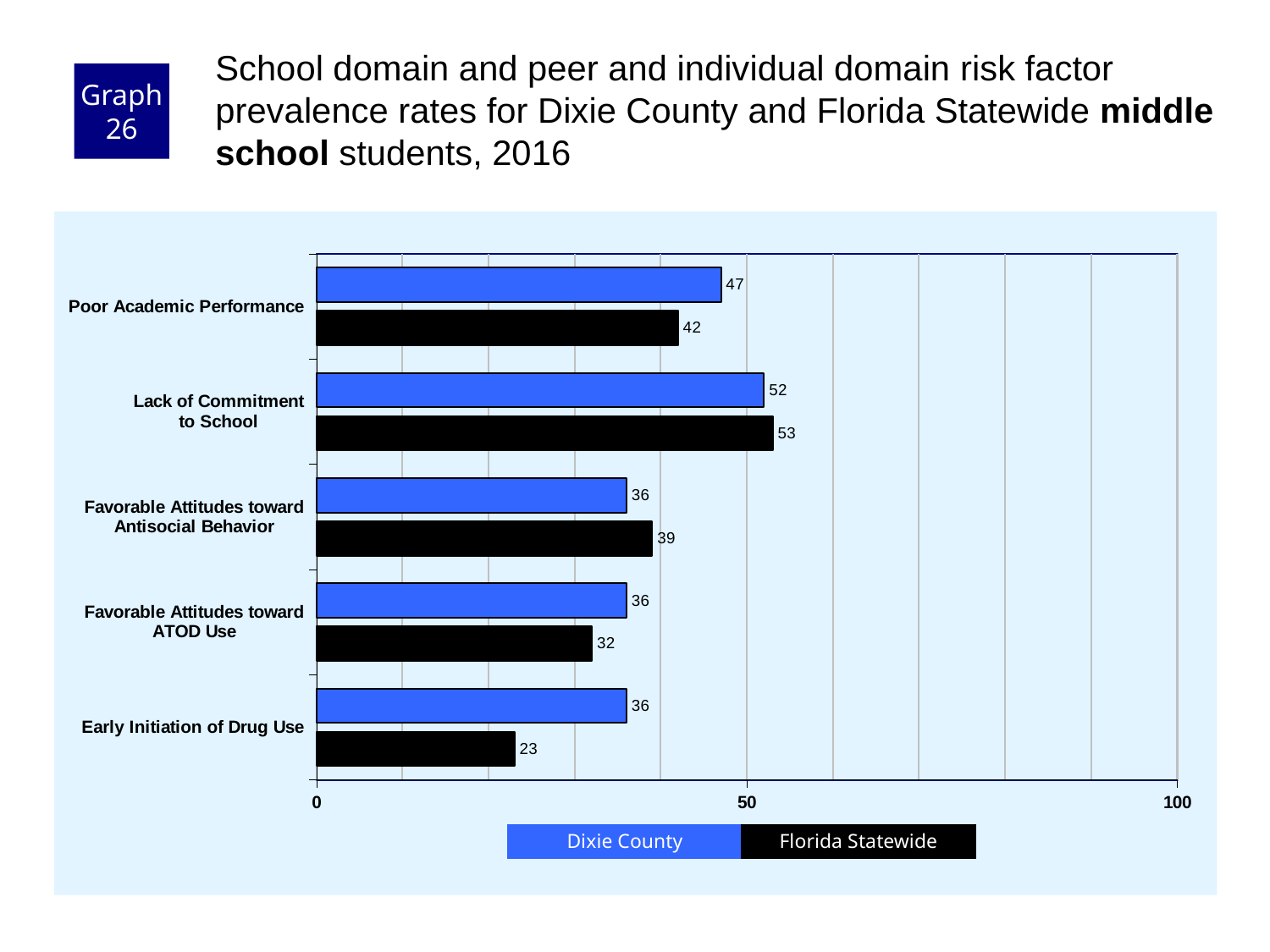
How many risk factors are shown on the chart? 5 Which risk factor has the lowest Florida Statewide value? Early Initiation of Drug Use What is the difference between the Dixie County and Florida Statewide values for Early Initiation of Drug Use? 13 How many series does the legend list? 2 Is the Dixie County value for Lack of Commitment to School greater or less than 50? greater Which risk factor has the highest Florida Statewide value? Lack of Commitment to School What is the Florida Statewide value for Lack of Commitment to School? 53 For Favorable Attitudes toward Antisocial Behavior, which is larger: the Dixie County value or the Florida Statewide value? Florida Statewide What kind of chart is shown on the slide? bar chart What is the Florida Statewide value for Early Initiation of Drug Use? 23 What is the difference between the Dixie County and Florida Statewide values for Poor Academic Performance? 5 What is the Dixie County value for Poor Academic Performance? 47